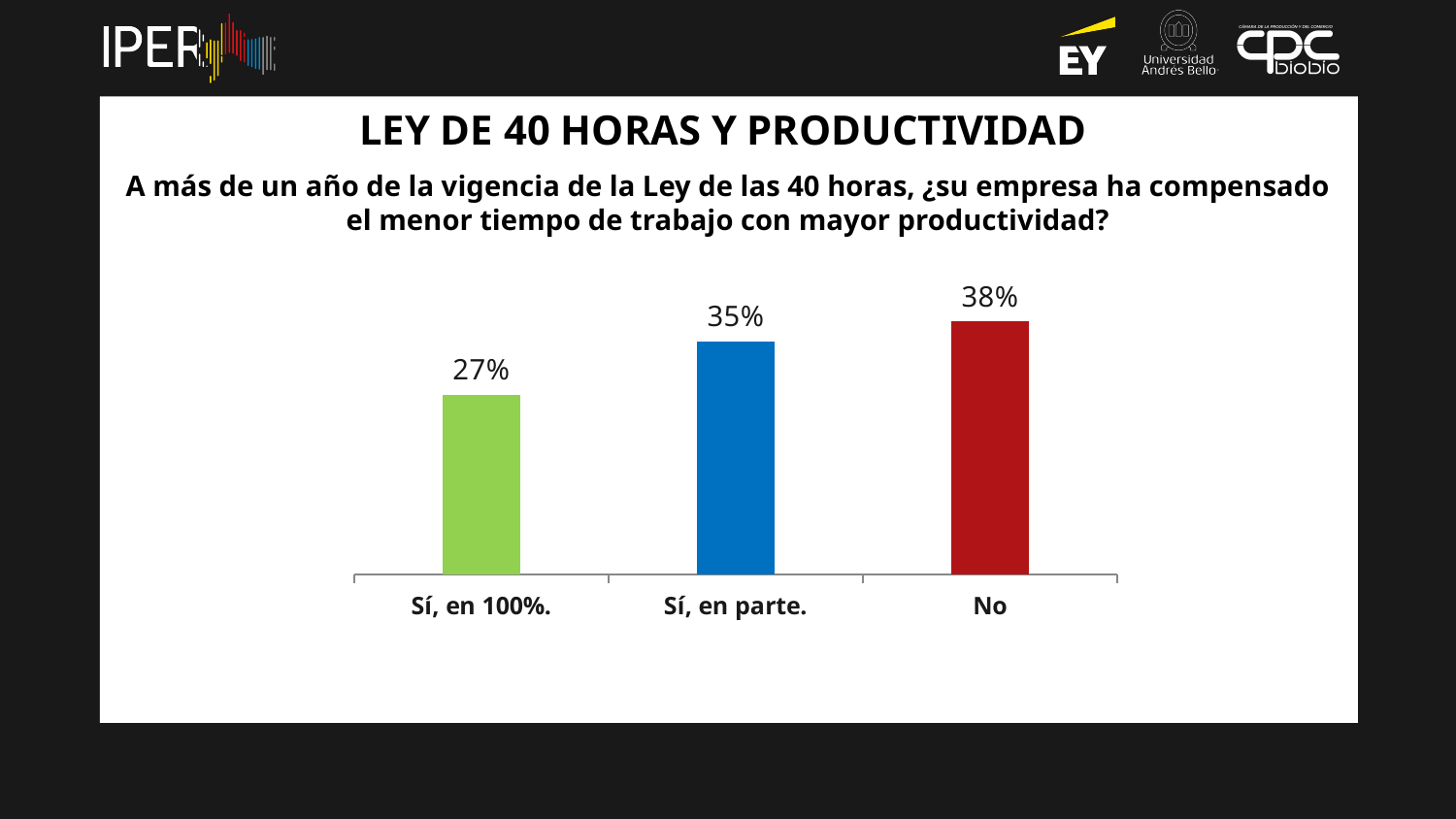
What percentage of companies answered "Sí, en 100%."? 27% Which is larger, the value for "Sí, en parte." or the value for "Sí, en 100%."? Sí, en parte. Which category has the lowest value? Sí, en 100%. What colour is the bar for the "No" category? Red What percentage is shown for the "No" category? 38% What is the value shown for "Sí, en parte."? 35% Which category has the highest value? No What is the difference between the "No" value and the "Sí, en 100%." value? 11% Do the values rise or fall from left to right along the x axis? Rise What kind of chart is shown on the slide? Bar chart What is the difference between "Sí, en parte." and "Sí, en 100%."? 8% How many categories are shown on the chart? 3